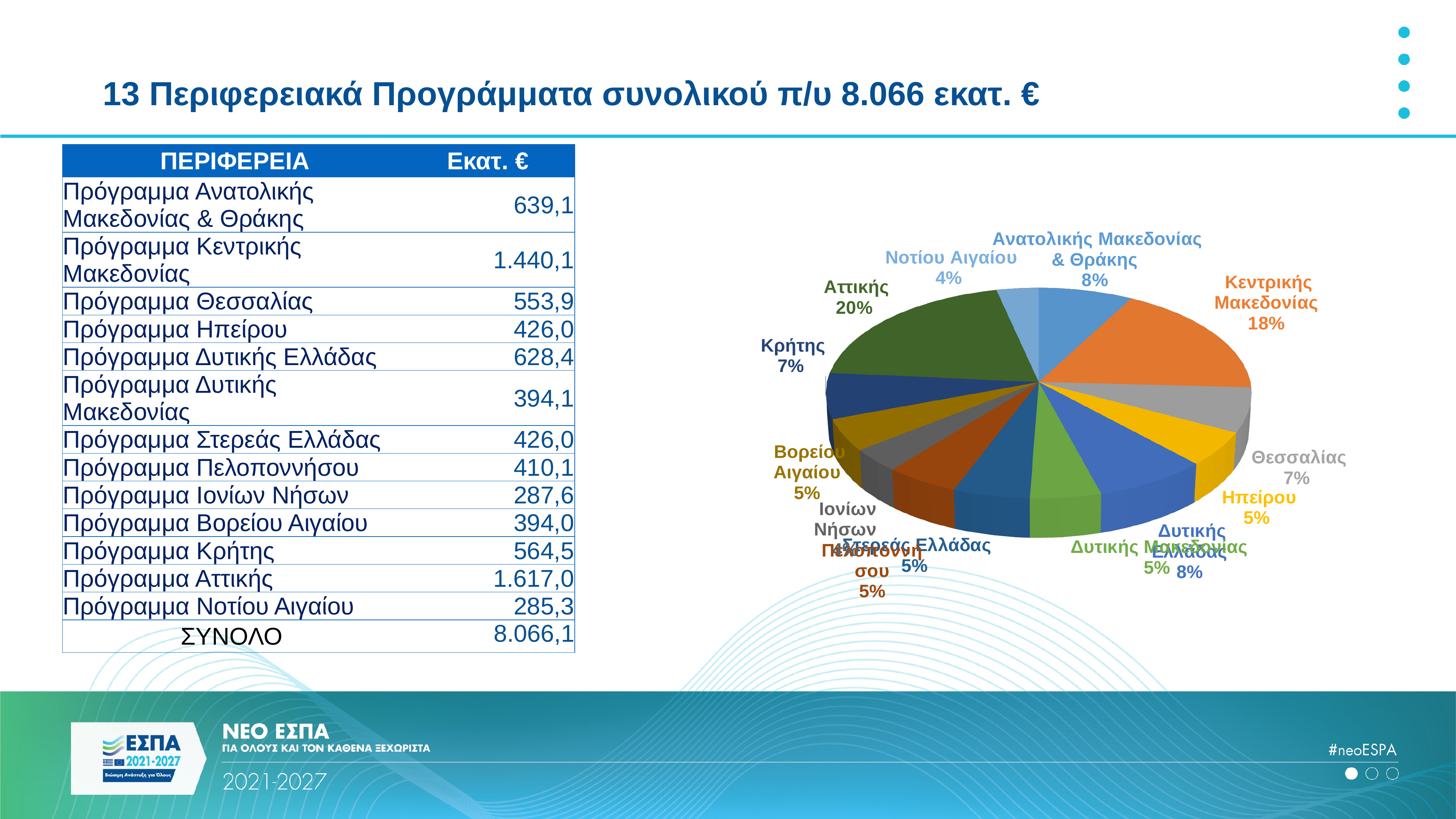
In the pie chart, what share does Θεσσαλίας have? 7% In the pie chart, what share does Βορείου Αιγαίου have? 5% In the pie chart, which is larger: the share of Κρήτης or the share of Ηπείρου? Κρήτης In the pie chart, what share does Ανατολικής Μακεδονίας & Θράκης have? 8% In the pie chart, how many percentage points larger is the share of Αττικής than the share of Κεντρικής Μακεδονίας? 2 What kind of chart is shown on the slide? pie chart In the pie chart, what share does Αττικής have? 20% In the pie chart, what share does Νοτίου Αιγαίου have? 4% Which region has the largest slice in the pie chart? Αττικής How many slices does the pie chart have? 13 In the pie chart, what share does Κεντρικής Μακεδονίας have? 18% What is the total budget stated in the slide title for the 13 regional programmes? 8.066 εκατ. €